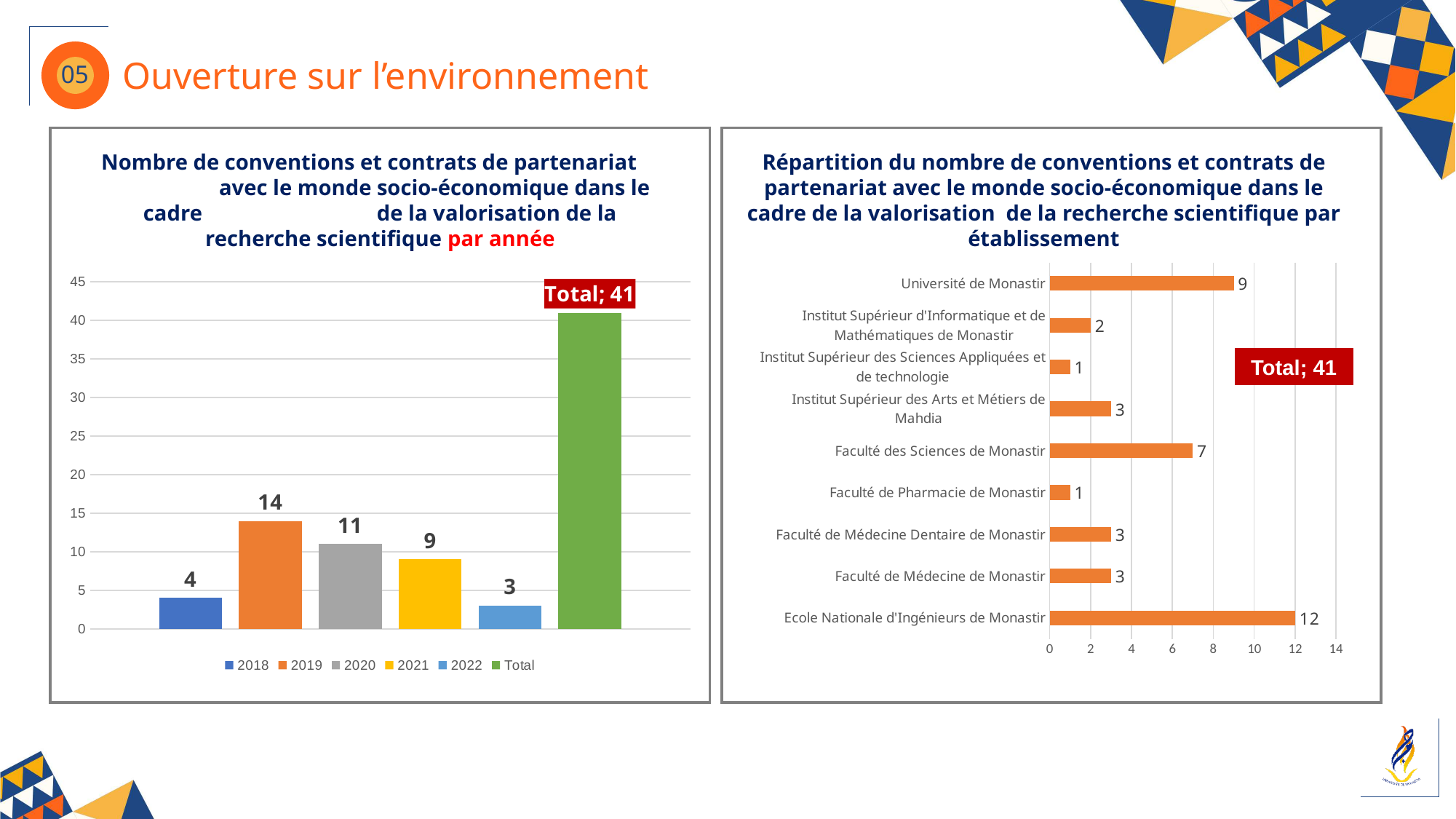
What kind of chart is the right chart (par établissement)? Bar chart In the left chart (par année), what is the difference between the values for 2020 and 2021? 2 In the left chart (par année), what total is shown in the red label? Total; 41 In the left chart (par année), how many conventions and contracts were there in 2019? 14 In the right chart (par établissement), what is the value for Ecole Nationale d'Ingénieurs de Monastir? 12 In the left chart (par année), what is the value for 2022? 3 In the left chart (par année), which year has the lowest number of conventions and contracts? 2022 In the right chart (par établissement), how many establishments are listed? 9 In the right chart (par établissement), which establishment has the highest number of conventions and contracts? Ecole Nationale d'Ingénieurs de Monastir In the left chart (par année), which year has the highest number of conventions and contracts? 2019 In the right chart (par établissement), what is the value for Faculté des Sciences de Monastir? 7 In the left chart (par année), how many entries does the legend list? 6